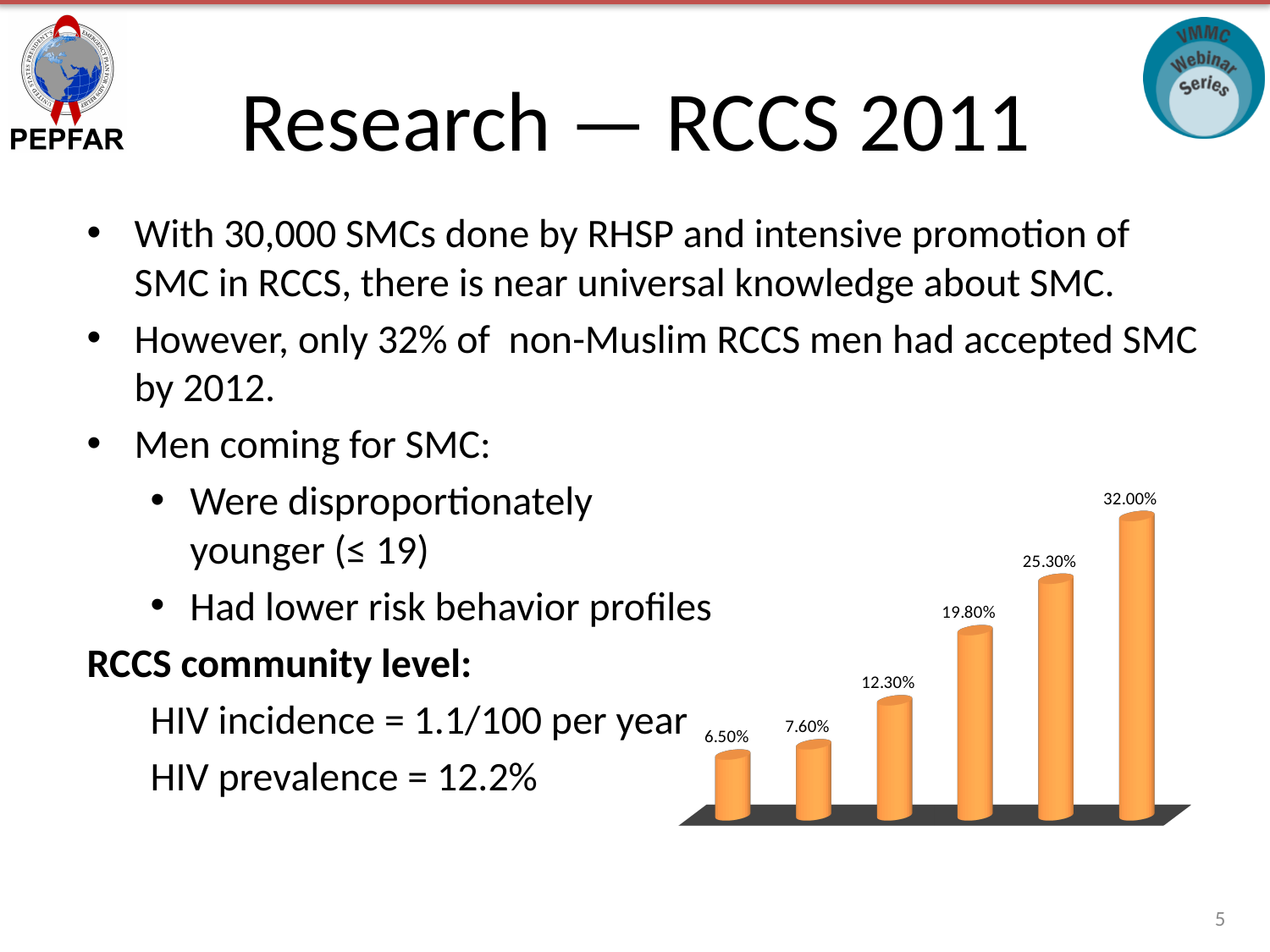
What colour are the bars in the chart? orange Which is larger in the chart: the second bar from the left or the fifth bar from the left? the fifth bar from the left How many bars does the chart on the slide have? 6 What kind of chart is shown on the slide? bar chart What is the lowest value labelled on the chart? 6.50% What is the difference between the rightmost bar (32.00%) and the leftmost bar (6.50%) in the chart? 25.50% What is the value shown on the third bar from the left in the chart? 12.30% What is the highest value labelled on the chart? 32.00% What is the value shown on the leftmost bar of the chart? 6.50% What is the value shown on the fourth bar from the left in the chart? 19.80% Do the bar values rise or fall from left to right across the chart? rise What is the value shown on the rightmost bar of the chart? 32.00%